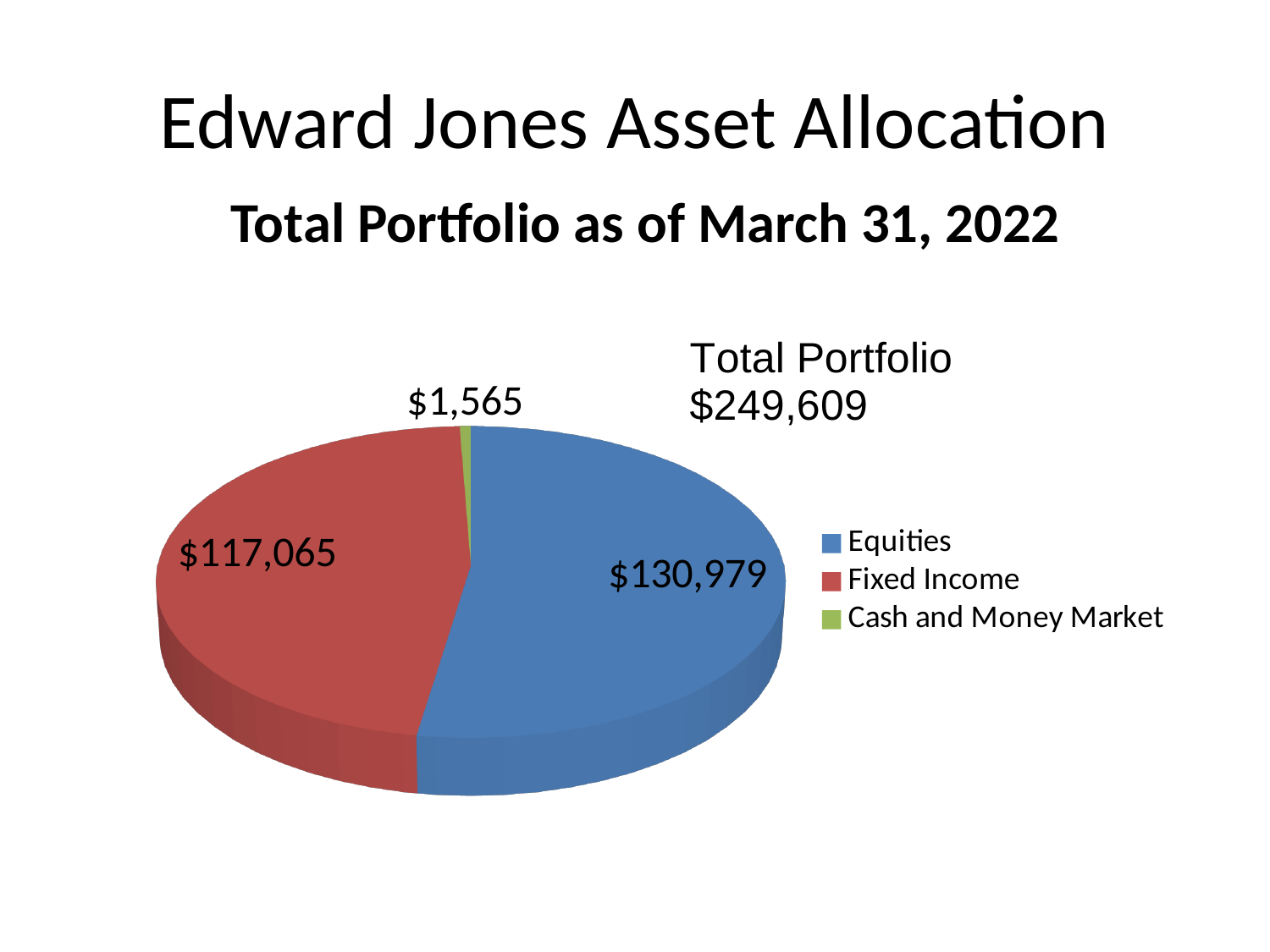
Which category has the smallest slice in the pie chart? Cash and Money Market What is the value of the Equities slice in the pie chart? $130,979 How many categories are shown in the pie chart? 3 What colour represents Fixed Income in the pie chart? Red What is the difference between the Equities value and the Fixed Income value? $13,914 Which is larger, the Equities slice or the Fixed Income slice? Equities What is the total portfolio value shown on the slide? $249,609 What is the value of the Fixed Income slice in the pie chart? $117,065 Which category has the largest slice in the pie chart? Equities What is the difference between the Fixed Income value and the Cash and Money Market value? $115,500 What kind of chart is shown on the slide? Pie chart What is the value of the Cash and Money Market slice in the pie chart? $1,565